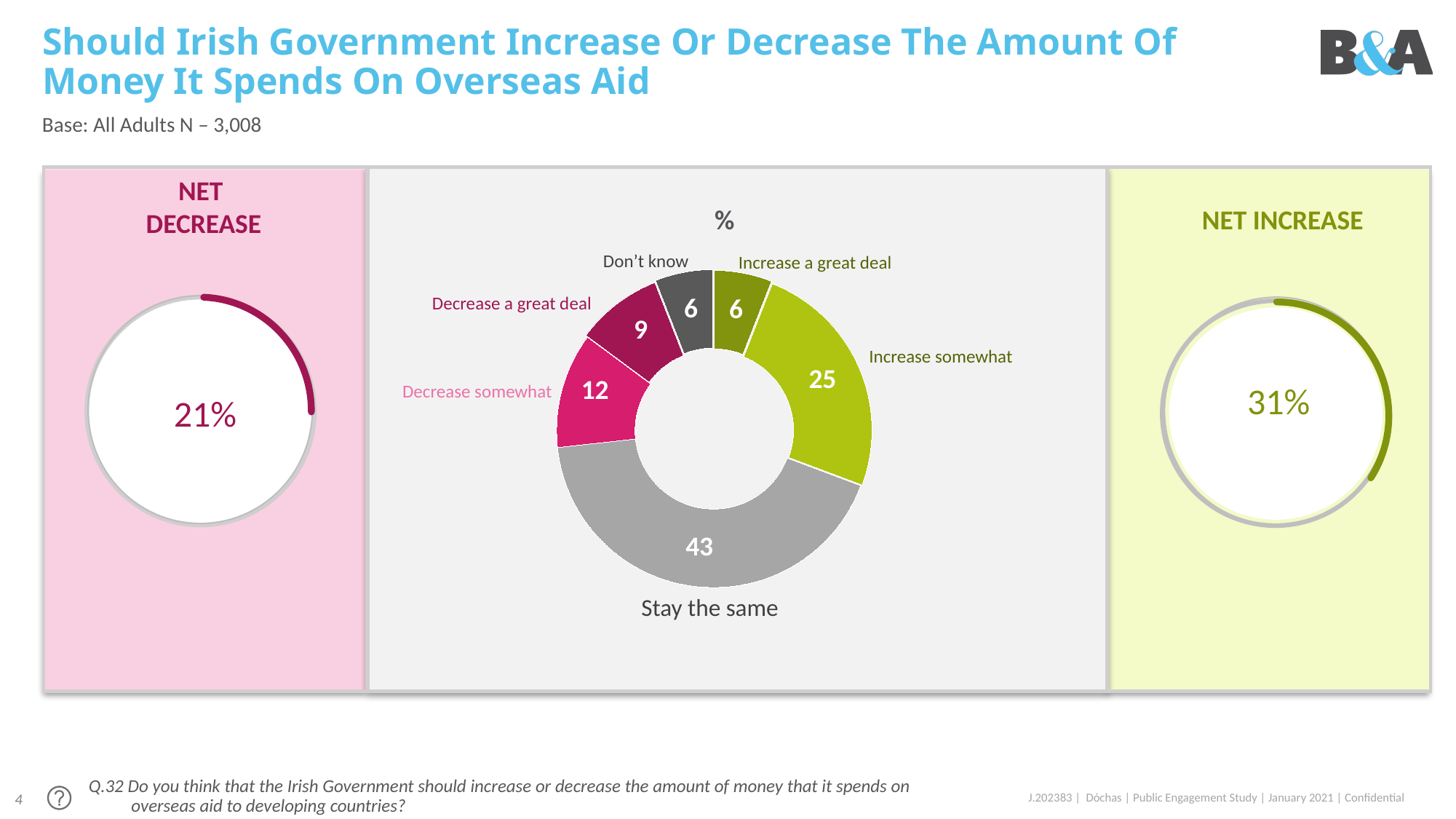
In the central donut chart, what is the combined value of 'Increase a great deal' and 'Increase somewhat'? 31 What percentage is shown in the 'NET DECREASE' gauge on the left? 21% In the central donut chart, what is the difference between 'Increase somewhat' and 'Decrease somewhat'? 13 In the central donut chart, which is larger: 'Decrease a great deal' or 'Increase a great deal'? Decrease a great deal What kind of chart is the central chart on the slide? Donut chart What percentage is shown in the 'NET INCREASE' gauge on the right? 31% In the central donut chart, what is the value for 'Decrease somewhat'? 12 In the central donut chart, what is the value for 'Decrease a great deal'? 9 In the central donut chart, which category has the highest value? Stay the same In the central donut chart, what is the value for 'Stay the same'? 43 In the central donut chart, what is the value for 'Increase somewhat'? 25 How many categories does the central donut chart show? 6